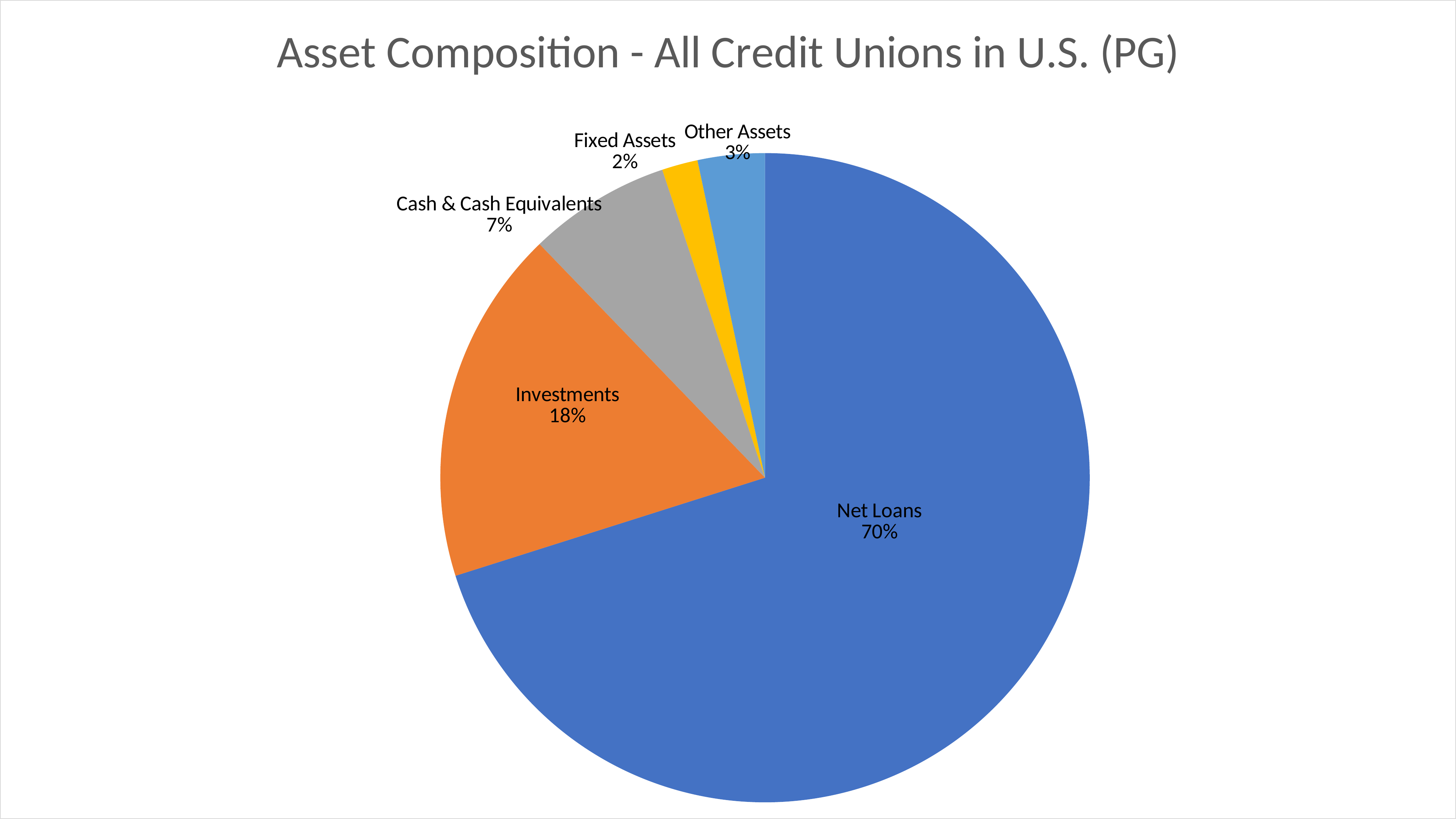
What share of assets is Fixed Assets? 2% What share of assets is Net Loans? 70% Which category has the largest slice of the pie? Net Loans What share of assets is Investments? 18% How many categories are shown in the pie chart? 5 What kind of chart is shown on the slide? Pie chart Which is larger, Other Assets or Fixed Assets? Other Assets What is the difference in percentage points between Net Loans and Investments? 52 What is the title of the chart? Asset Composition - All Credit Unions in U.S. (PG) Which category has the smallest slice of the pie? Fixed Assets